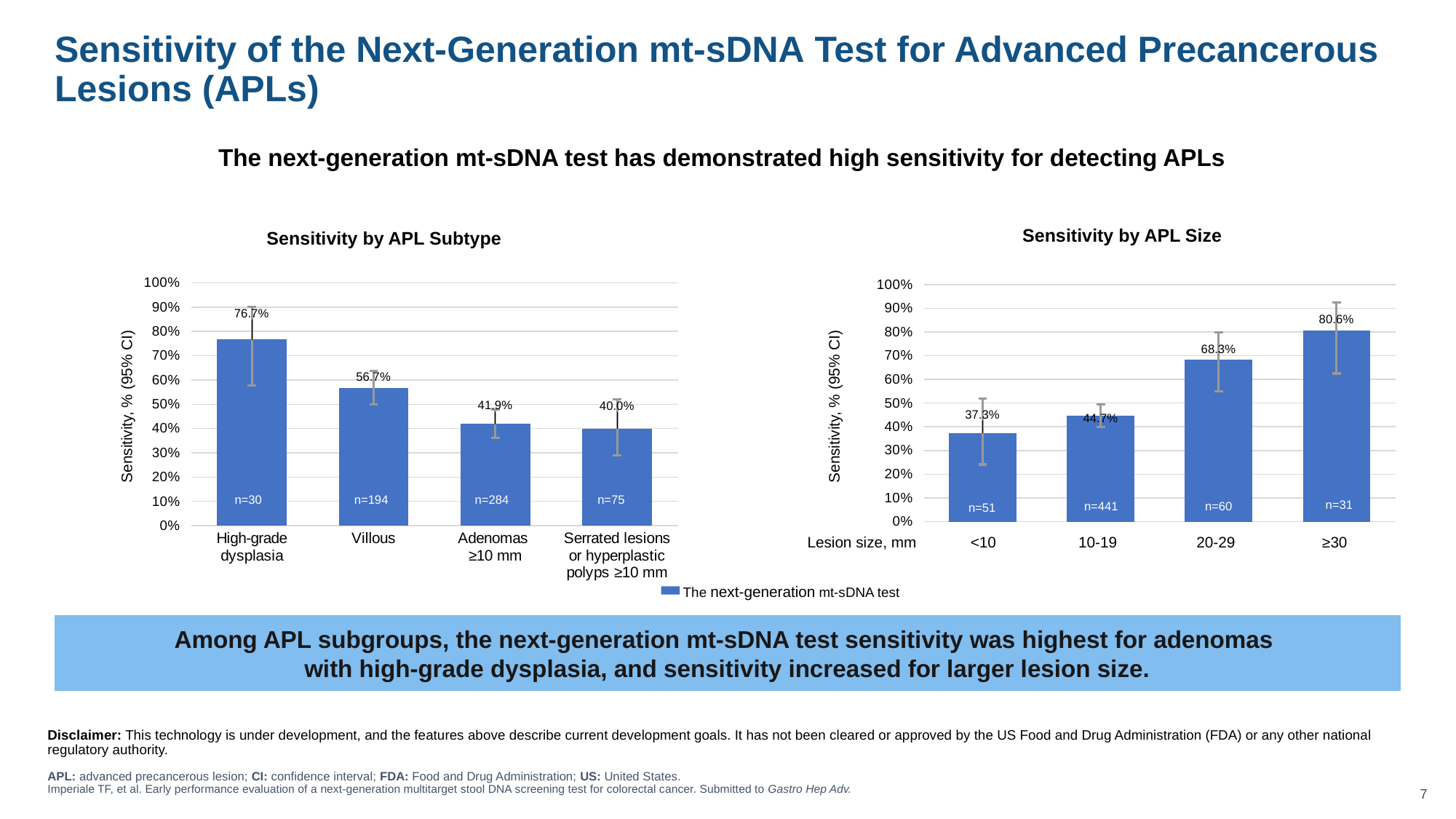
In the 'Sensitivity by APL Size' chart, what is the sensitivity for lesions ≥30 mm? 80.6% In the 'Sensitivity by APL Size' chart, which lesion size category has the highest sensitivity? ≥30 In the 'Sensitivity by APL Subtype' chart, how many categories are shown? 4 In the 'Sensitivity by APL Subtype' chart, what is the sensitivity for High-grade dysplasia? 76.7% In the 'Sensitivity by APL Size' chart, do the sensitivity values rise or fall as lesion size increases along the x axis? rise In the 'Sensitivity by APL Size' chart, what is the sensitivity for lesions 10-19 mm? 44.7% What kind of chart is 'Sensitivity by APL Size'? bar chart In the 'Sensitivity by APL Subtype' chart, what is the difference in sensitivity between High-grade dysplasia and Adenomas ≥10 mm? 34.8% In the 'Sensitivity by APL Subtype' chart, what is the sensitivity for Villous? 56.7% In the 'Sensitivity by APL Subtype' chart, what is the n value shown for Adenomas ≥10 mm? n=284 In the 'Sensitivity by APL Size' chart, what is the difference in sensitivity between the 20-29 mm and <10 mm categories? 31.0% In the 'Sensitivity by APL Subtype' chart, which category has the lowest sensitivity? Serrated lesions or hyperplastic polyps ≥10 mm